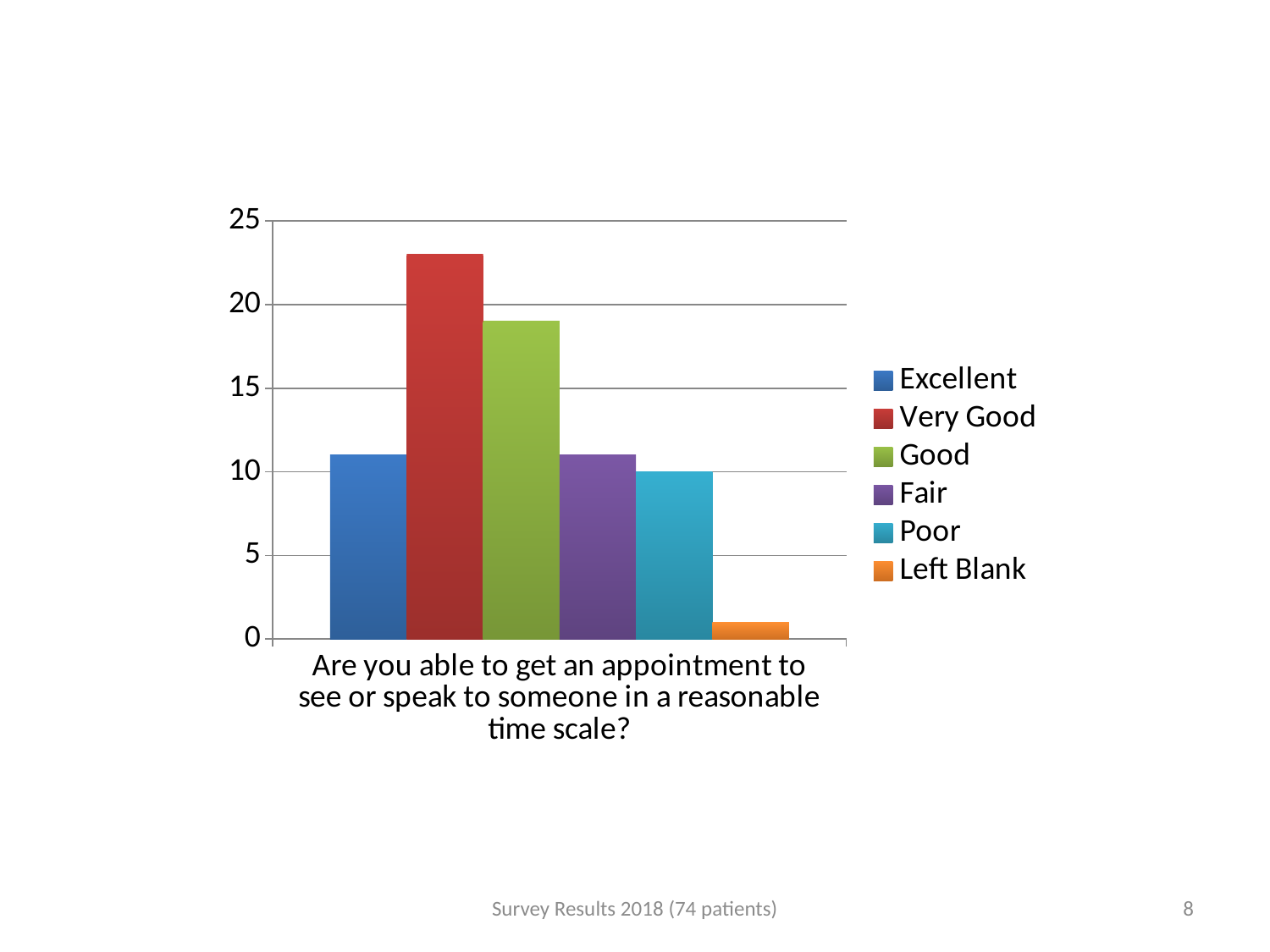
What question is shown as the category label on the x axis? Are you able to get an appointment to see or speak to someone in a reasonable time scale? Which series has the lowest bar? Left Blank Is the value for Good greater or less than 20? less Which is larger, the value for Very Good or the value for Good? Very Good What kind of chart is shown on the slide? bar chart Is the value for Left Blank greater or less than 5? less What is the value for Poor? 10 How many series does the legend list? 6 Is the value for Good greater or less than 15? greater Which series has the highest bar? Very Good Which is larger, the value for Fair or the value for Left Blank? Fair